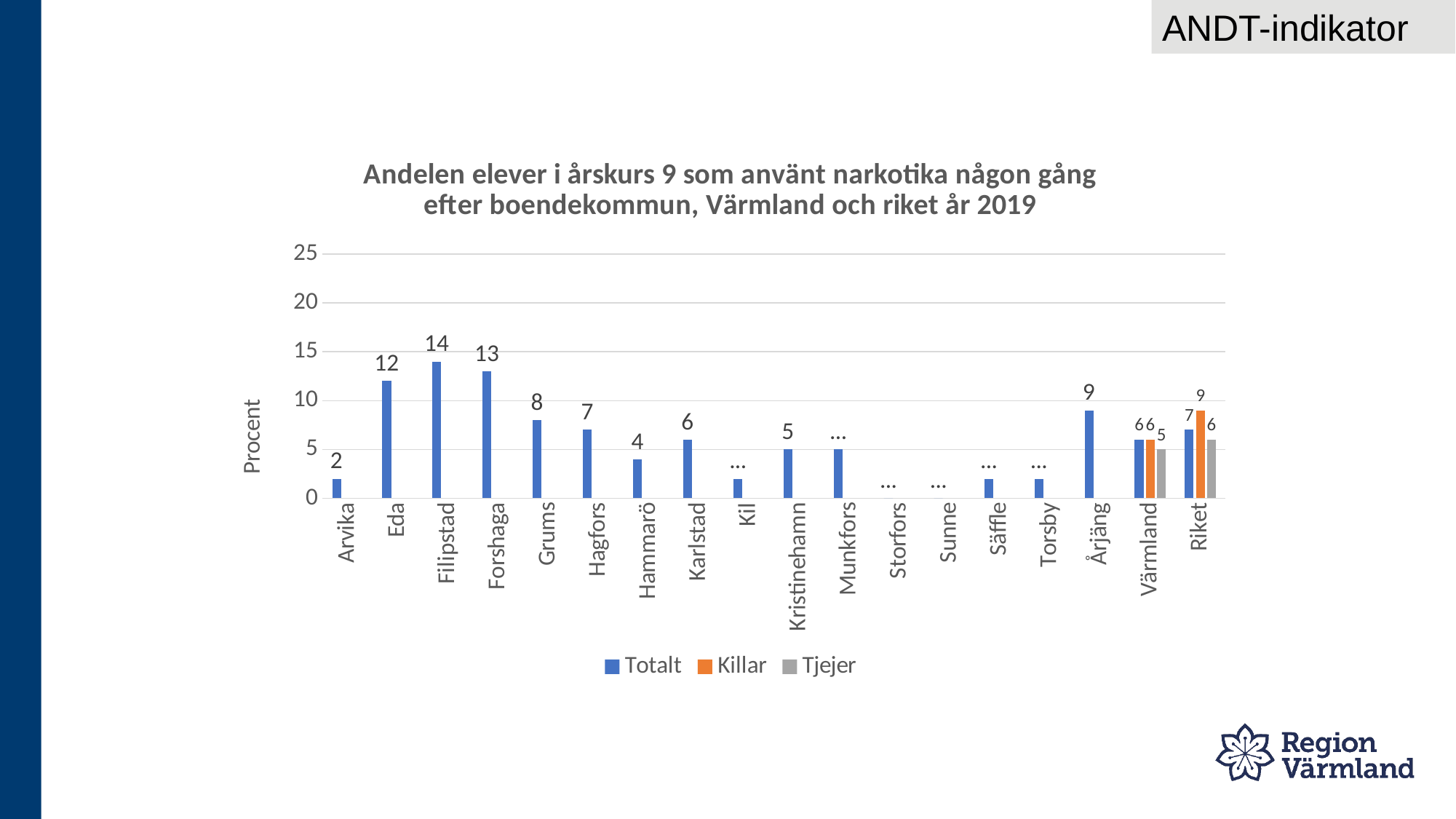
Which municipality has the highest Totalt value? Filipstad What is the difference between the Totalt values for Filipstad and Eda? 2 What kind of chart is shown on the slide? bar chart How many series does the legend list? 3 What is the Totalt value for Årjäng? 9 Which has a larger Totalt value, Eda or Forshaga? Forshaga What is the difference between the Killar and Tjejer values for Riket? 3 What is the Tjejer value for Värmland? 5 How many categories are shown on the x axis? 18 What is the Totalt value for Filipstad? 14 Is the Totalt value for Hammarö greater or less than 5? less What is the Killar value for Riket? 9